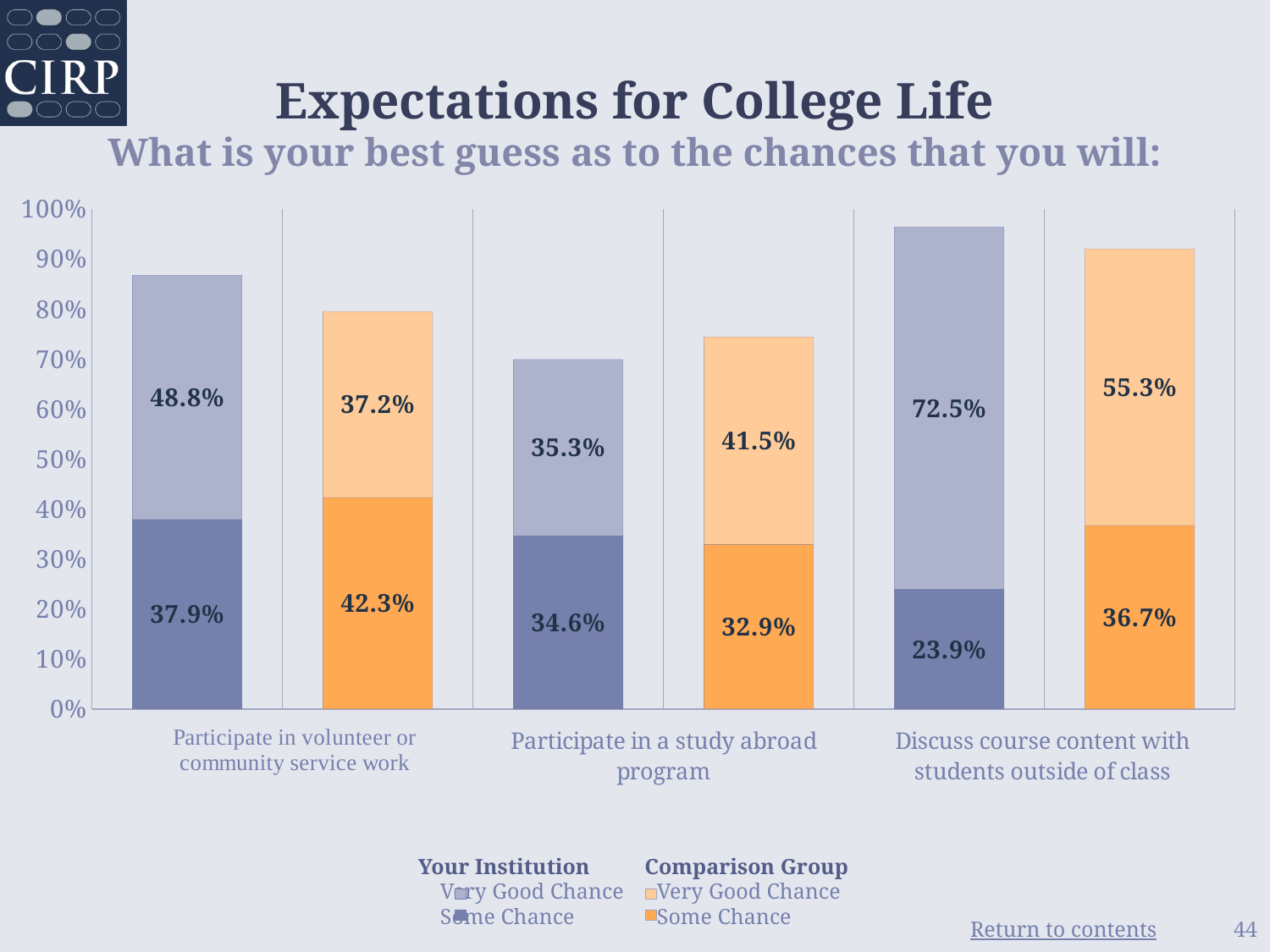
How many entries does the legend list? 4 What is the difference between the Comparison Group's 'Very Good Chance' value and Your Institution's 'Very Good Chance' value for 'Discuss course content with students outside of class'? 17.2% Which category has the lowest 'Some Chance' value for Your Institution? Discuss course content with students outside of class For 'Participate in a study abroad program', which is larger: Your Institution's 'Very Good Chance' value or the Comparison Group's 'Very Good Chance' value? Comparison Group Which category has the highest 'Very Good Chance' value for Your Institution? Discuss course content with students outside of class What is the total height of the stacked bar for the Comparison Group for 'Discuss course content with students outside of class'? 92.0% What is the total height of the stacked bar for Your Institution for 'Participate in volunteer or community service work'? 86.7% What is the 'Very Good Chance' value for Your Institution for 'Discuss course content with students outside of class'? 72.5% What is the 'Some Chance' value for the Comparison Group for 'Participate in volunteer or community service work'? 42.3% How many categories are shown on the x axis? 3 What kind of chart is shown on the slide? Stacked bar chart What is the 'Very Good Chance' value for the Comparison Group for 'Participate in a study abroad program'? 41.5%